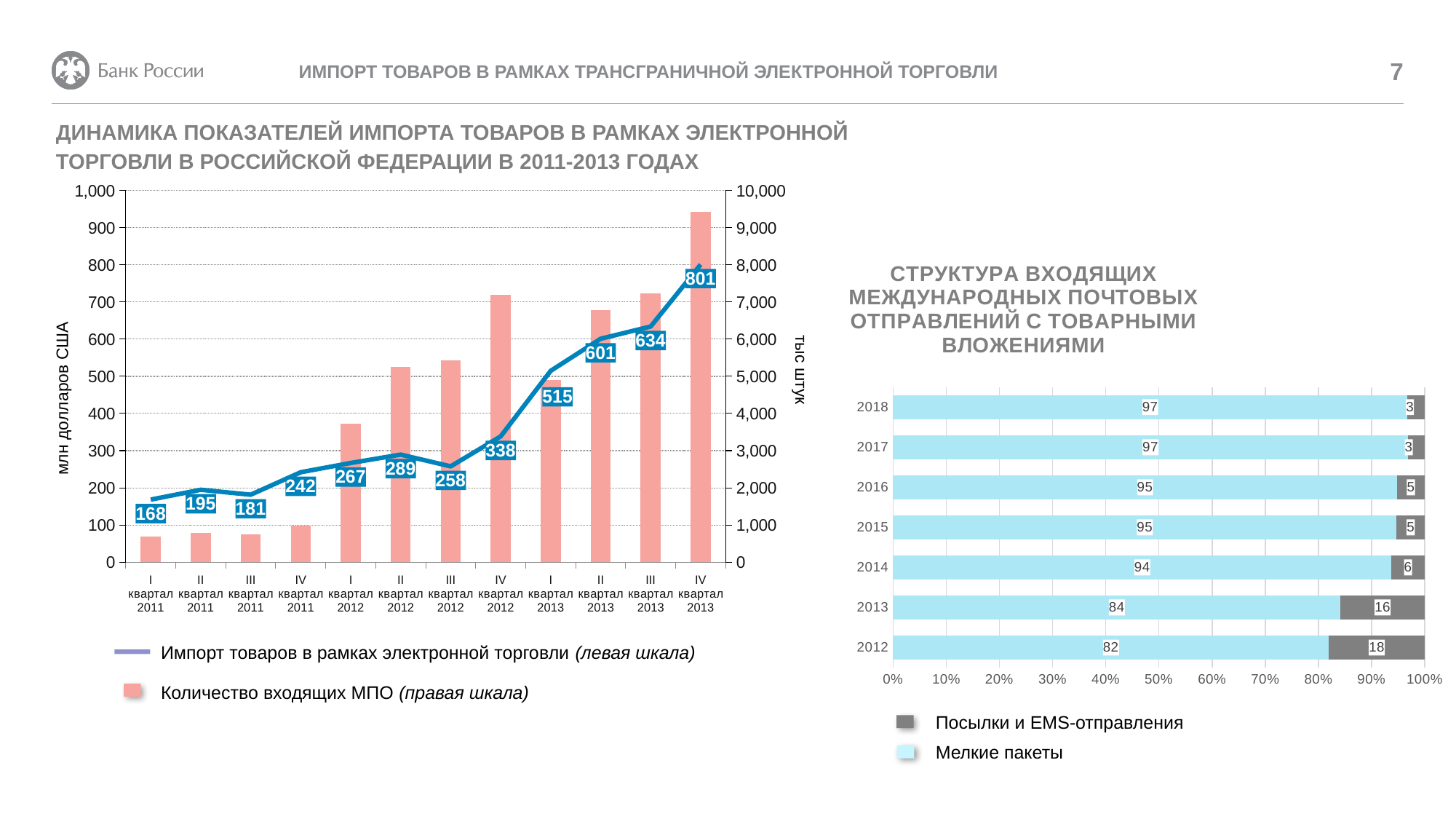
In the left chart (Динамика показателей импорта товаров), is the bar for Количество входящих МПО in IV квартал 2013 greater or less than 9,000 on the right scale? greater In the left chart (Динамика показателей импорта товаров), is the import line value for II квартал 2012 larger or smaller than for III квартал 2012? larger In the right chart (Структура входящих международных почтовых отправлений), which year has the highest share of Посылки и EMS-отправления? 2012 In the left chart (Динамика показателей импорта товаров), does the import line generally rise or fall from I квартал 2011 to IV квартал 2013? rise In the left chart (Динамика показателей импорта товаров), what is the value of the import line for IV квартал 2013? 801 In the right chart (Структура входящих международных почтовых отправлений), how many series does the legend list? 2 In the right chart (Структура входящих международных почтовых отправлений), what is the share of Мелкие пакеты in 2012? 82 In the left chart (Динамика показателей импорта товаров), what is the difference between the import line values for IV квартал 2013 and III квартал 2013? 167 In the left chart (Динамика показателей импорта товаров), what is the value of the import line for III квартал 2012? 258 What kind of chart is the right chart (Структура входящих международных почтовых отправлений)? stacked bar chart In the left chart (Динамика показателей импорта товаров), which quarter has the lowest value on the import line? I квартал 2011 In the left chart (Динамика показателей импорта товаров), how many quarters are shown on the x axis? 12